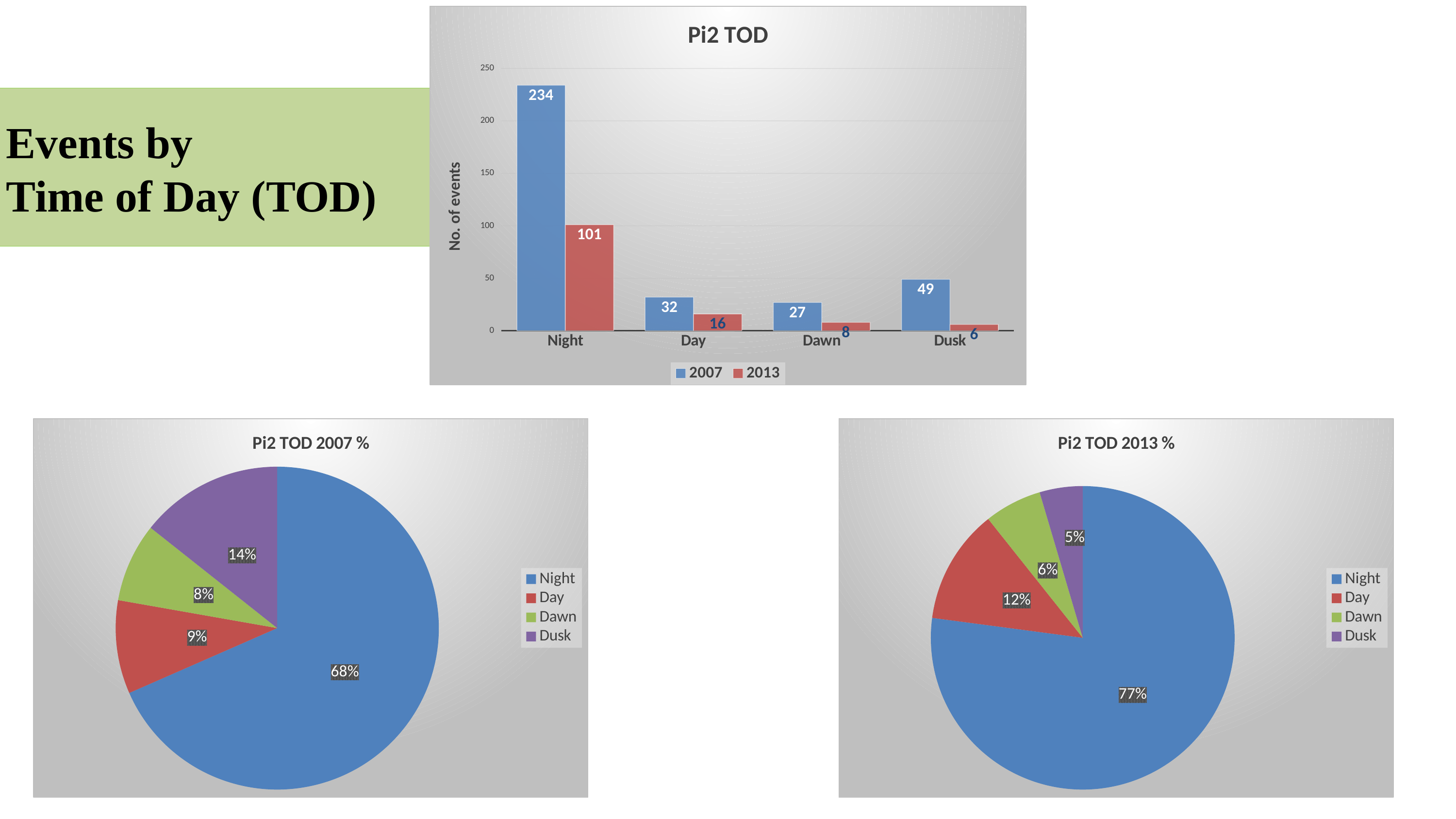
What kind of chart is 'Pi2 TOD' at the top of the slide? bar chart In the 'Pi2 TOD' bar chart, which is larger: the 2007 value for Dusk or the 2007 value for Day? Dusk In the 'Pi2 TOD' bar chart, what is the difference between the 2007 and 2013 values for Night? 133 In the 'Pi2 TOD' bar chart, how many categories are shown on the x axis? 4 In the 'Pi2 TOD' bar chart, what is the value for Night in 2007? 234 In the 'Pi2 TOD' bar chart, how many series does the legend list? 2 In the 'Pi2 TOD' bar chart, which category has the lowest value for 2013? Dusk In the 'Pi2 TOD 2013 %' pie chart, what share does Day have? 12% In the 'Pi2 TOD 2007 %' pie chart, what share does Night have? 68% In the 'Pi2 TOD' bar chart, what is the value for Dawn in 2013? 8 In the 'Pi2 TOD' bar chart, which category has the highest value for 2007? Night In the 'Pi2 TOD 2013 %' pie chart, which slice is the smallest? Dusk